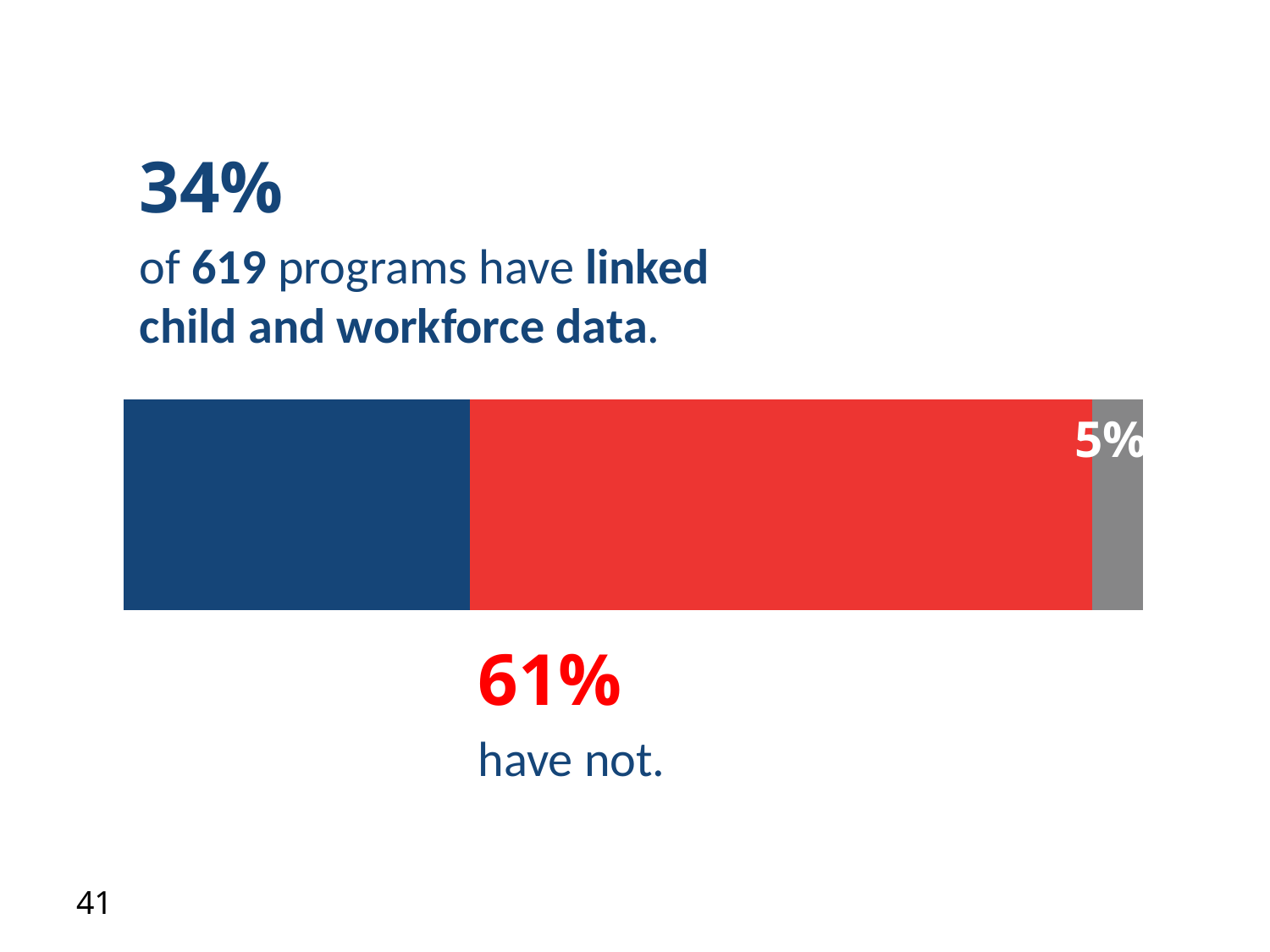
Which segment of the bar is the largest? 61% (have not) What is the total of the three segments in the bar? 100% How many segments does the bar have? 3 How many programs are represented in the bar? 619 What value is printed on the grey segment of the bar? 5% Which segment of the bar is the smallest? 5% (grey) What is the difference between the share of programs that have not linked data and the share that have? 27% What percentage of programs have not linked child and workforce data? 61% Which is larger: the share of programs that have linked child and workforce data or the share that have not? have not (61%) What percentage of programs have linked child and workforce data? 34% What kind of chart is shown on the slide? stacked bar chart What colour is the segment representing programs that have linked child and workforce data? blue